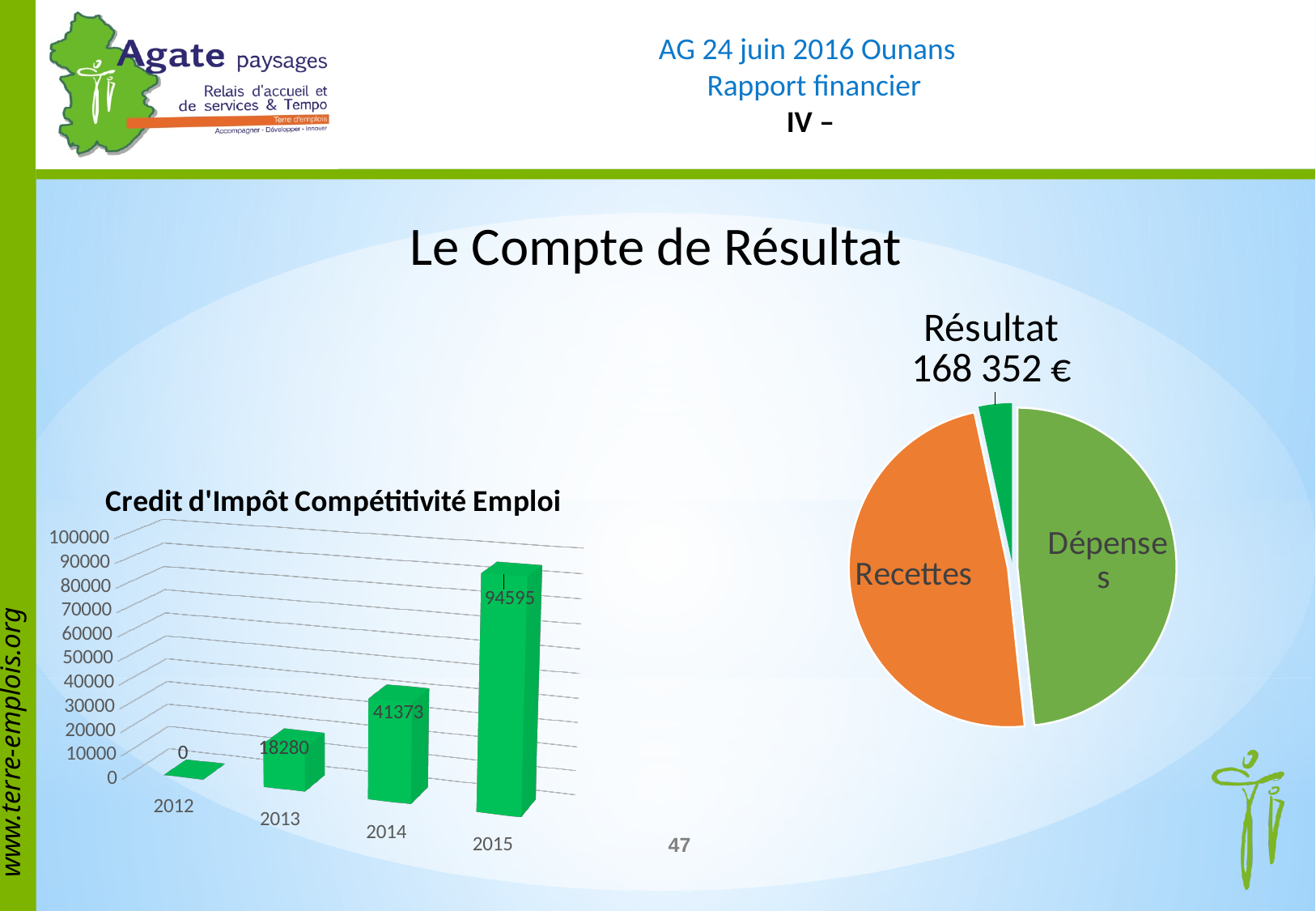
In the 'Credit d'Impôt Compétitivité Emploi' chart, what is the value for 2015? 94595 What kind of chart is the 'Credit d'Impôt Compétitivité Emploi' chart? bar chart In the 'Credit d'Impôt Compétitivité Emploi' chart, do the values rise or fall from 2012 to 2015? rise In the 'Credit d'Impôt Compétitivité Emploi' chart, what is the value for 2013? 18280 In the 'Credit d'Impôt Compétitivité Emploi' chart, what is the value for 2014? 41373 In the 'Credit d'Impôt Compétitivité Emploi' chart, how many years are shown on the x axis? 4 In the 'Credit d'Impôt Compétitivité Emploi' chart, what is the difference between the 2015 and 2014 values? 53222 In the 'Credit d'Impôt Compétitivité Emploi' chart, what is the value for 2012? 0 In the pie chart on the right, what value is given for Résultat? 168 352 € In the 'Credit d'Impôt Compétitivité Emploi' chart, which year has the lowest value? 2012 In the 'Credit d'Impôt Compétitivité Emploi' chart, which year has the highest value? 2015 In the 'Credit d'Impôt Compétitivité Emploi' chart, which is larger, the value for 2013 or the value for 2014? 2014